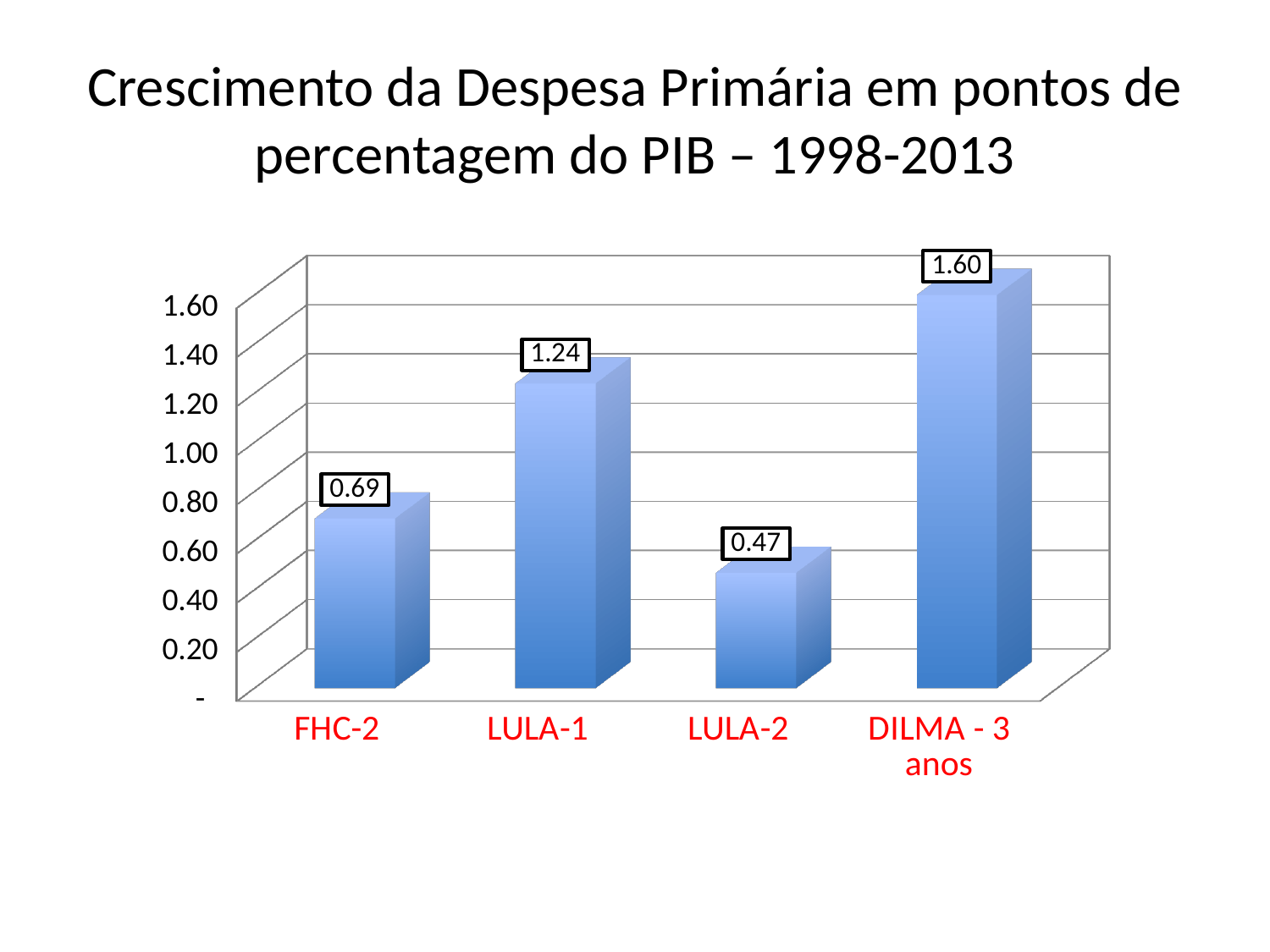
Which category has the highest value? DILMA - 3 anos What is the difference between the values for FHC-2 and LULA-2? 0.22 What is the title of the chart? Crescimento da Despesa Primária em pontos de percentagem do PIB – 1998-2013 What is the difference between the values for DILMA - 3 anos and LULA-1? 0.36 How many categories are shown on the x axis? 4 What is the value for LULA-1? 1.24 What is the value for FHC-2? 0.69 What is the value for LULA-2? 0.47 What kind of chart is shown on the slide? Bar chart Which is larger, the value for LULA-1 or the value for FHC-2? LULA-1 Which category has the lowest value? LULA-2 What is the value for DILMA - 3 anos? 1.60